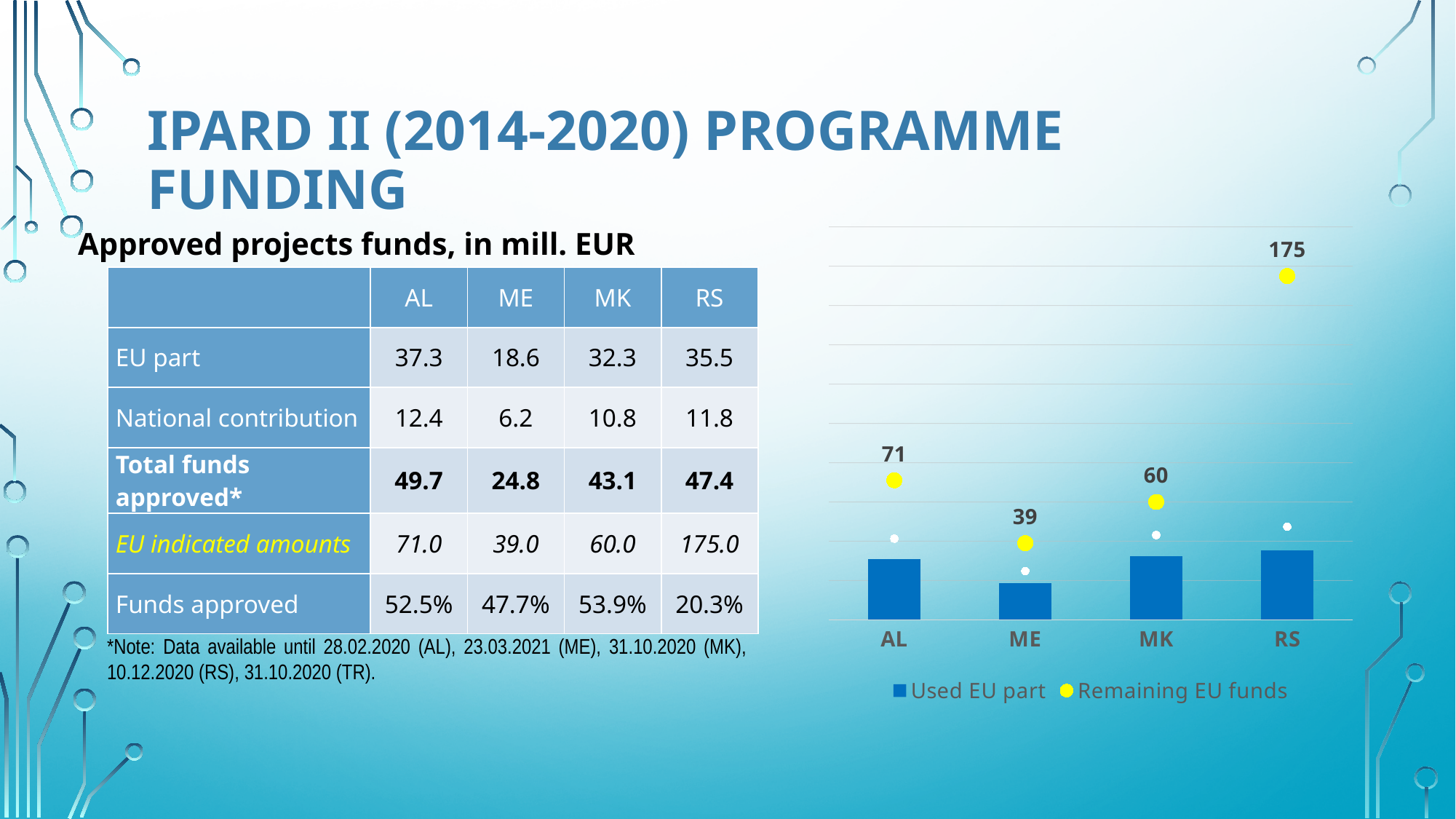
In the chart, which has the taller Used EU part bar, ME or RS? RS In the chart, what is the labelled value of Remaining EU funds for MK? 60 In the chart, which country has the lowest Remaining EU funds value? ME What kind of chart is shown on the right of the slide? Bar chart How many series does the chart's legend list? 2 How many countries are shown on the x axis of the chart? 4 In the chart, what is the labelled value of Remaining EU funds for RS? 175 In the chart, which country has the highest Remaining EU funds value? RS In the chart, what is the difference between the Remaining EU funds values for MK and ME? 21 In the chart, what is the labelled value of Remaining EU funds for AL? 71 In the chart, what is the difference between the Remaining EU funds values for RS and AL? 104 In the chart, what is the labelled value of Remaining EU funds for ME? 39